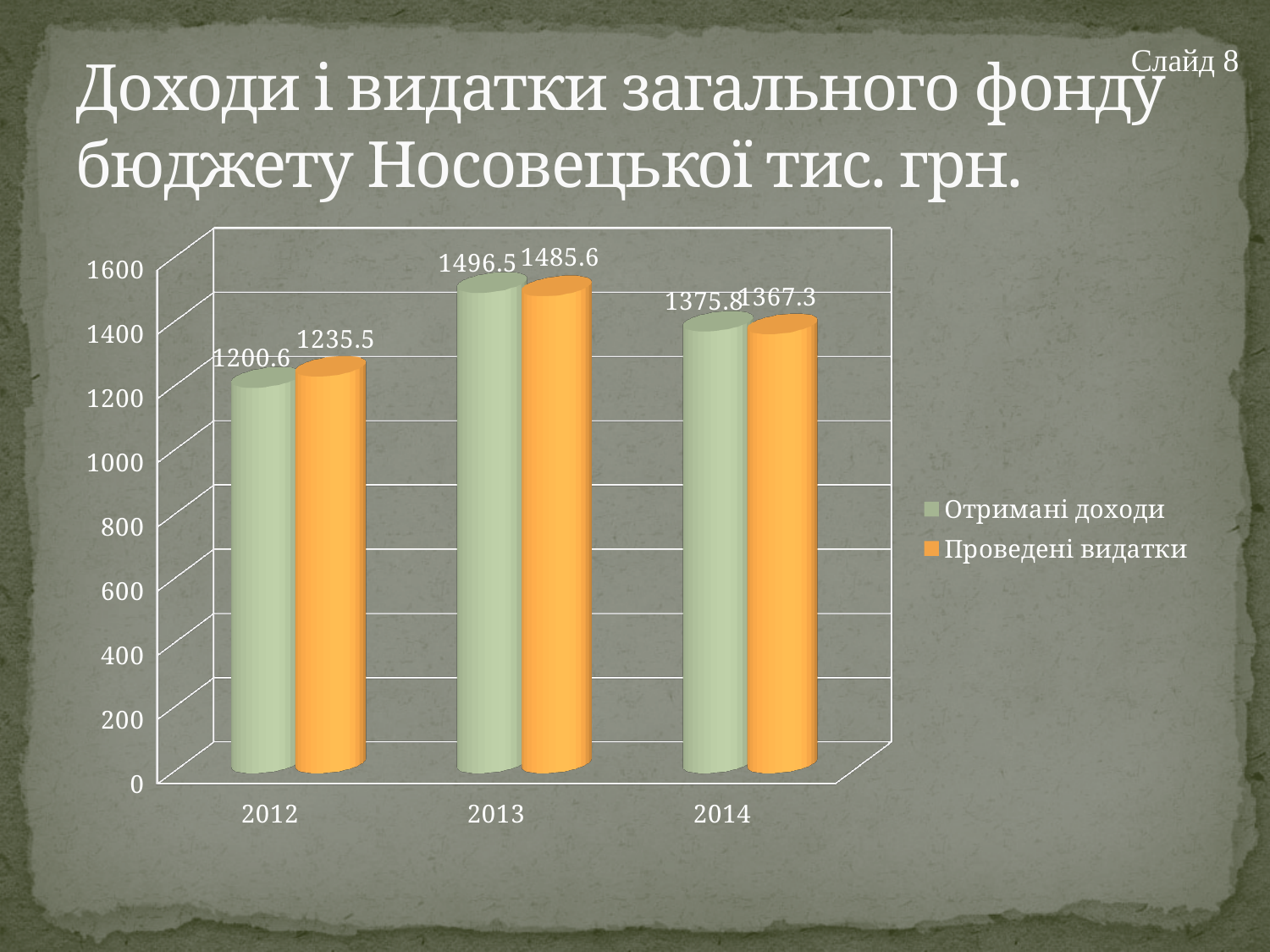
What is the difference between Отримані доходи and Проведені видатки in 2012? 34.9 Is the value of Отримані доходи for 2014 greater or less than 1200? greater In which year is Проведені видатки lowest? 2012 What is the value of Проведені видатки for 2014? 1367.3 What is the value of Проведені видатки for 2013? 1485.6 How many years are shown on the x axis? 3 What is the difference between Отримані доходи in 2013 and in 2014? 120.7 What kind of chart is shown on the slide? bar chart How many series does the legend list? 2 What is the value of Отримані доходи for 2012? 1200.6 In which year is Отримані доходи highest? 2013 Which is larger in 2012: Отримані доходи or Проведені видатки? Проведені видатки